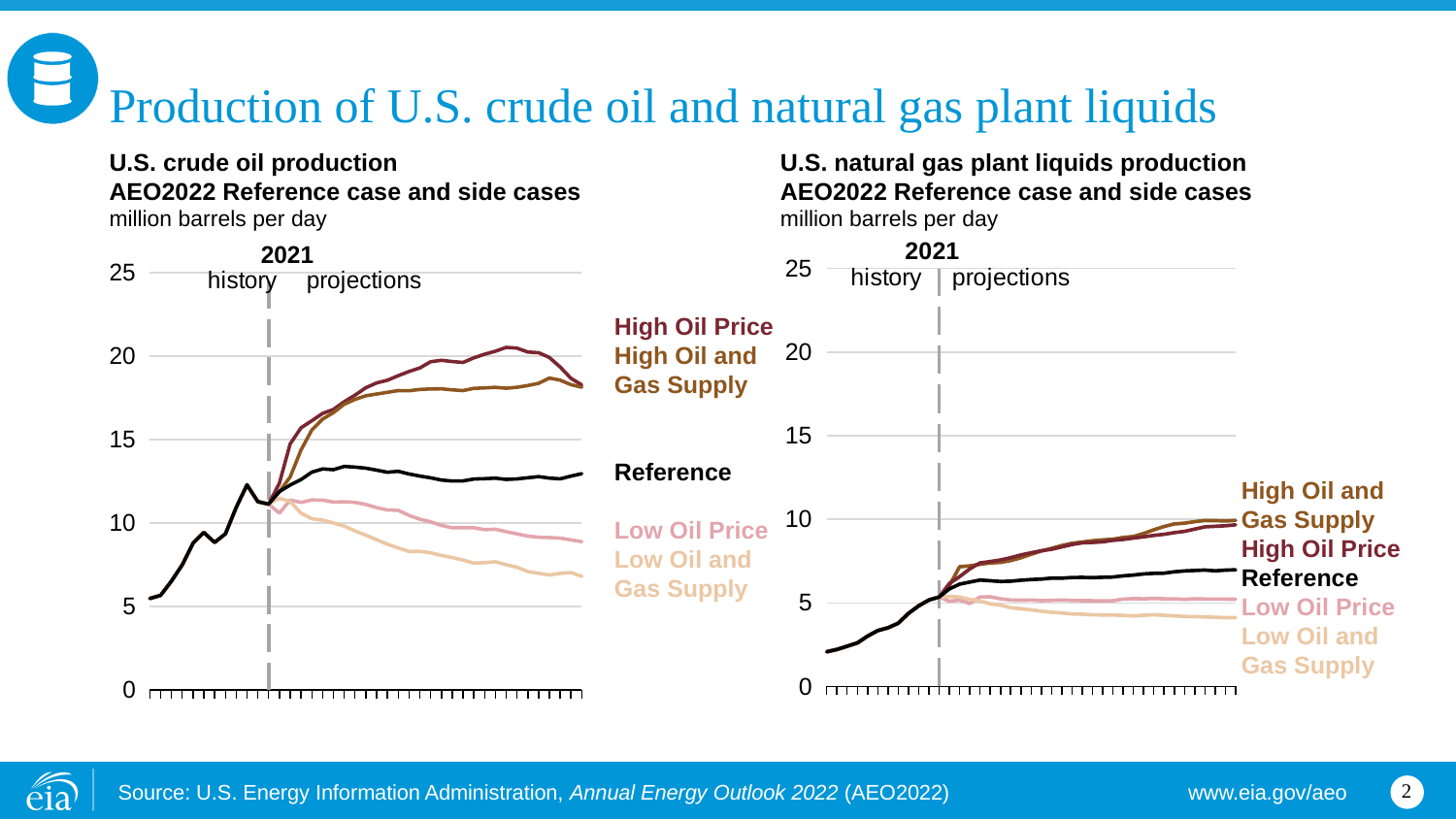
In the U.S. natural gas plant liquids production chart, is the Reference case value at the end of the projection period greater or less than 5? greater In the U.S. crude oil production chart, is the Reference case value at the end of the projection period greater or less than 10? greater In the U.S. crude oil production chart, does the Low Oil and Gas Supply case rise or fall over the projection period? fall In the U.S. crude oil production chart, is the High Oil Price case value at the end of the projection period greater or less than 15? greater How many series (cases) are labeled on the U.S. natural gas plant liquids production chart? 5 What kind of chart is the U.S. crude oil production chart? line chart In the U.S. crude oil production chart, which case is higher at the end of the projection period: High Oil Price or Low Oil Price? High Oil Price What unit is used on both charts? million barrels per day In the U.S. natural gas plant liquids production chart, does the Reference case rise or fall over the projection period? rise What year does the dashed vertical line separating history from projections mark on the charts? 2021